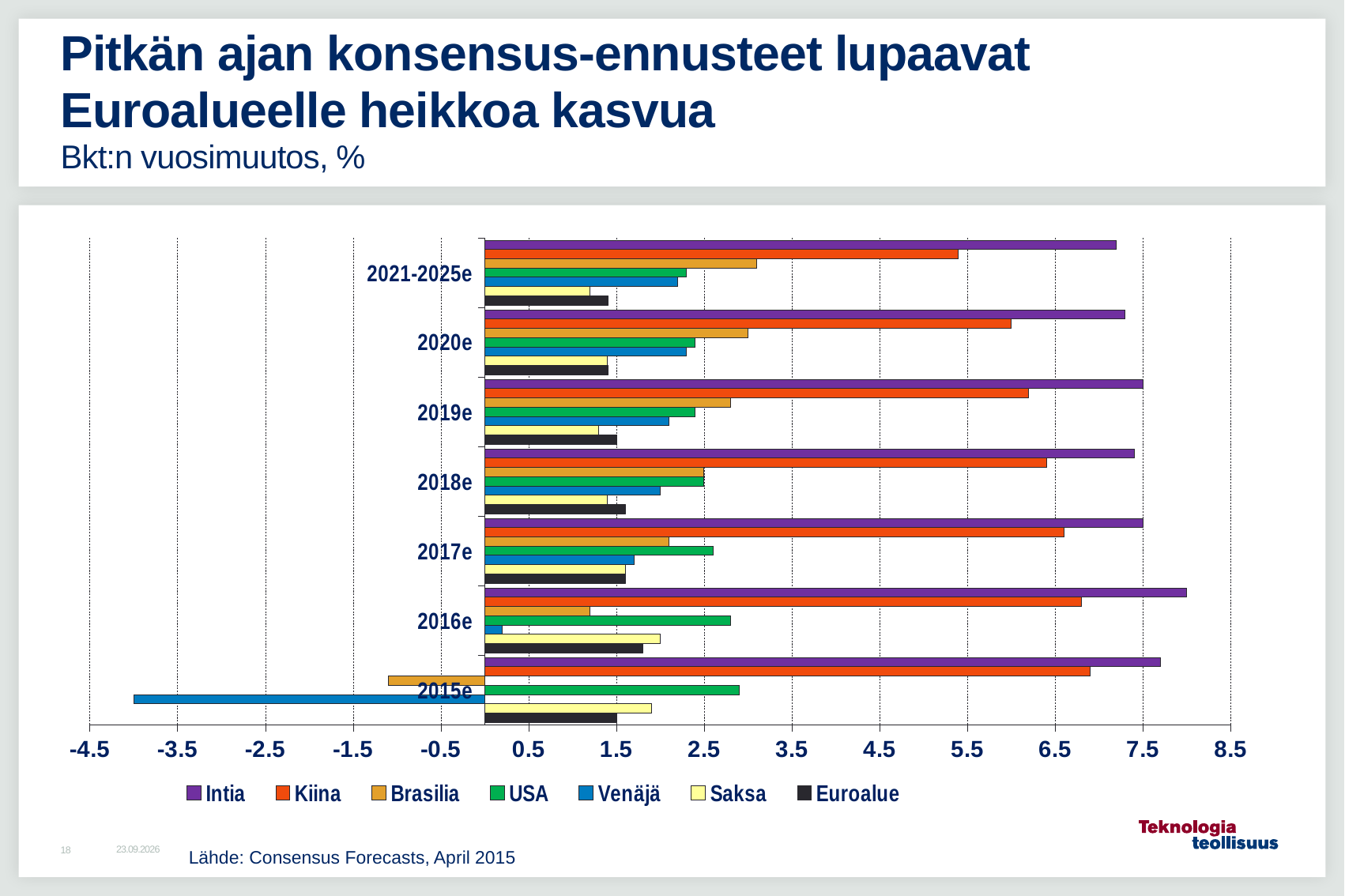
In 2015e, which is larger, the value for Kiina or the value for USA? Kiina Is the value for Kiina in 2016e greater or less than 1.5? greater Is the value for Brasilia in 2015e greater or less than -0.5? less How many period categories are shown on the chart? 7 How many series does the legend list? 7 Is the value for Venäjä in 2015e greater or less than -3.5? less Which series is shown in purple in the legend? Intia In 2017e, which is larger, the value for USA or the value for Kiina? Kiina What kind of chart is shown on the slide? bar chart Which country has the lowest value in 2015e? Venäjä Which country has the highest value in 2016e? Intia